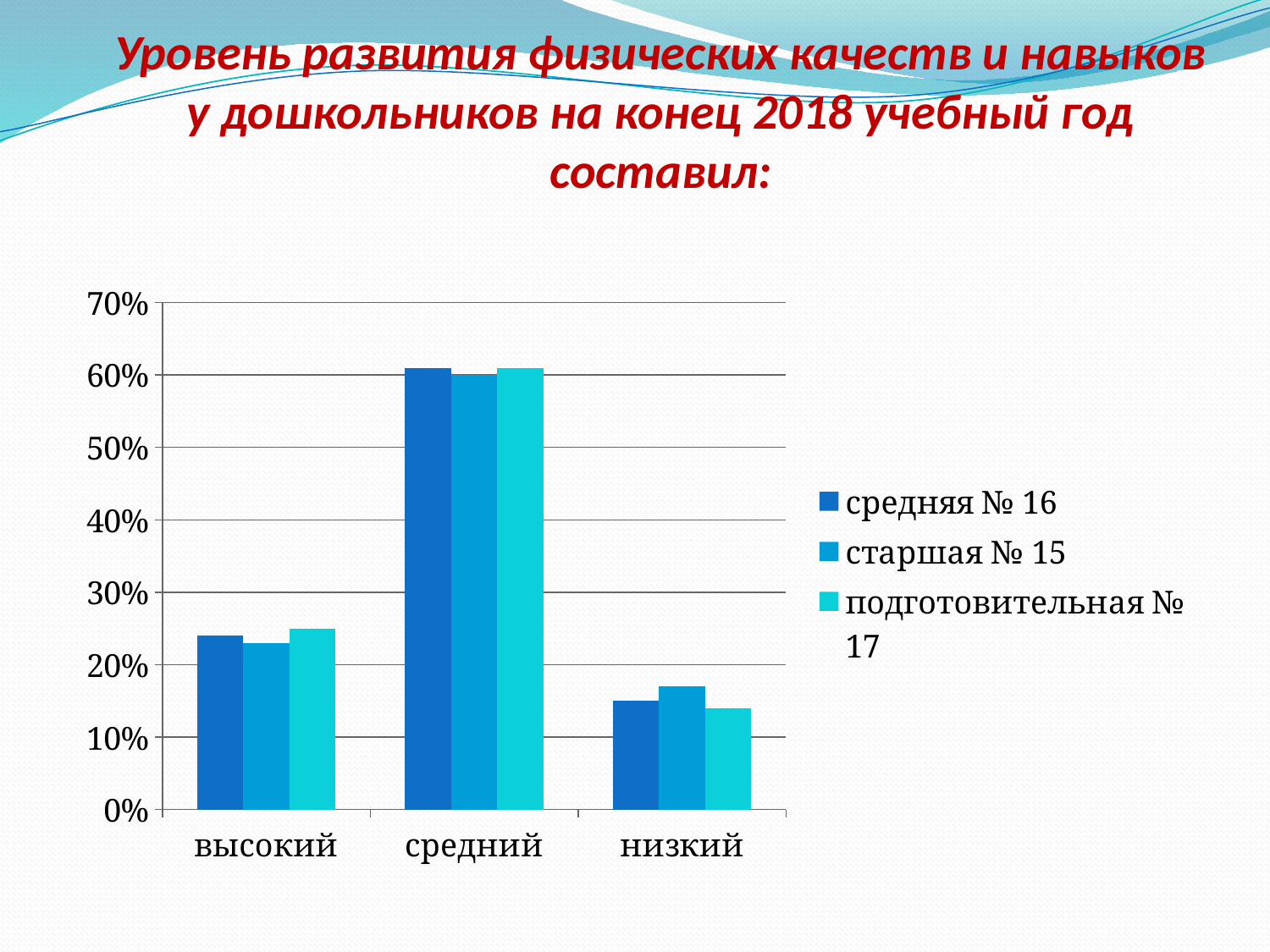
Is the value for старшая № 15 in the средний category greater or less than 50%? greater Which legend entry is shown in the lightest (cyan) colour? подготовительная № 17 Is the value for подготовительная № 17 in the низкий category greater or less than 20%? less Is the value for подготовительная № 17 in the высокий category greater or less than 30%? less Which category has the lowest value for средняя № 16? низкий For старшая № 15, which is larger: the value for высокий or the value for низкий? высокий How many series does the legend list? 3 How many categories are shown on the x axis? 3 What kind of chart is shown on the slide? bar chart Which category has the highest values for all three groups? средний